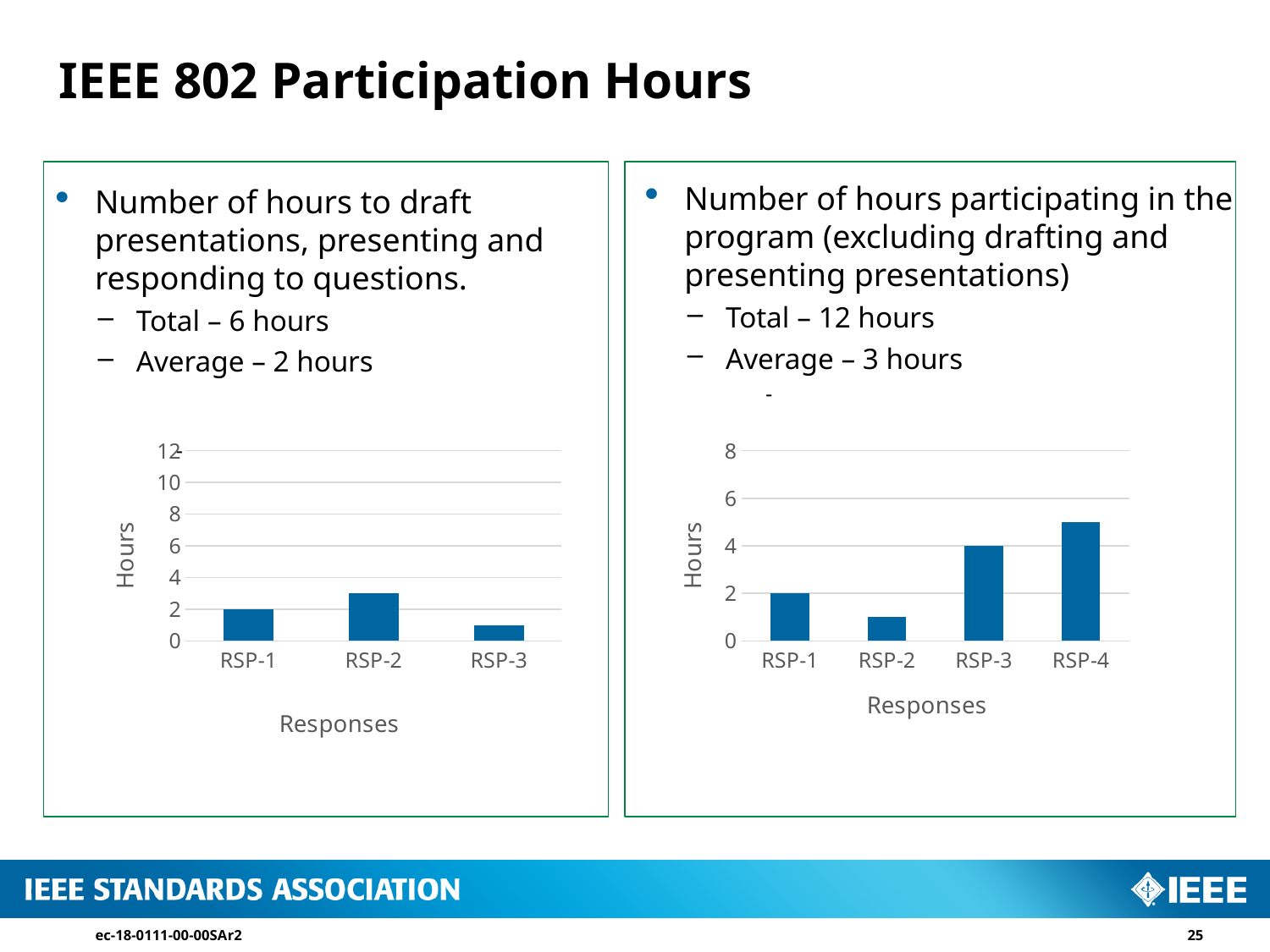
On the left chart, which response has the highest number of hours? RSP-2 On the right chart, what is the value for RSP-1? 2 On the right chart, which response has the lowest number of hours? RSP-2 On the left chart, is the value for RSP-2 greater or less than 2? greater How many responses are shown on the right chart? 4 What kind of chart is the left chart? bar chart On the right chart, which response has the highest number of hours? RSP-4 On the right chart, what is the value for RSP-3? 4 On the right chart, what is the difference between the values for RSP-3 and RSP-1? 2 On the left chart, which response has the lowest number of hours? RSP-3 On the right chart, is the value for RSP-4 greater or less than 4? greater On the left chart, what is the value for RSP-1? 2